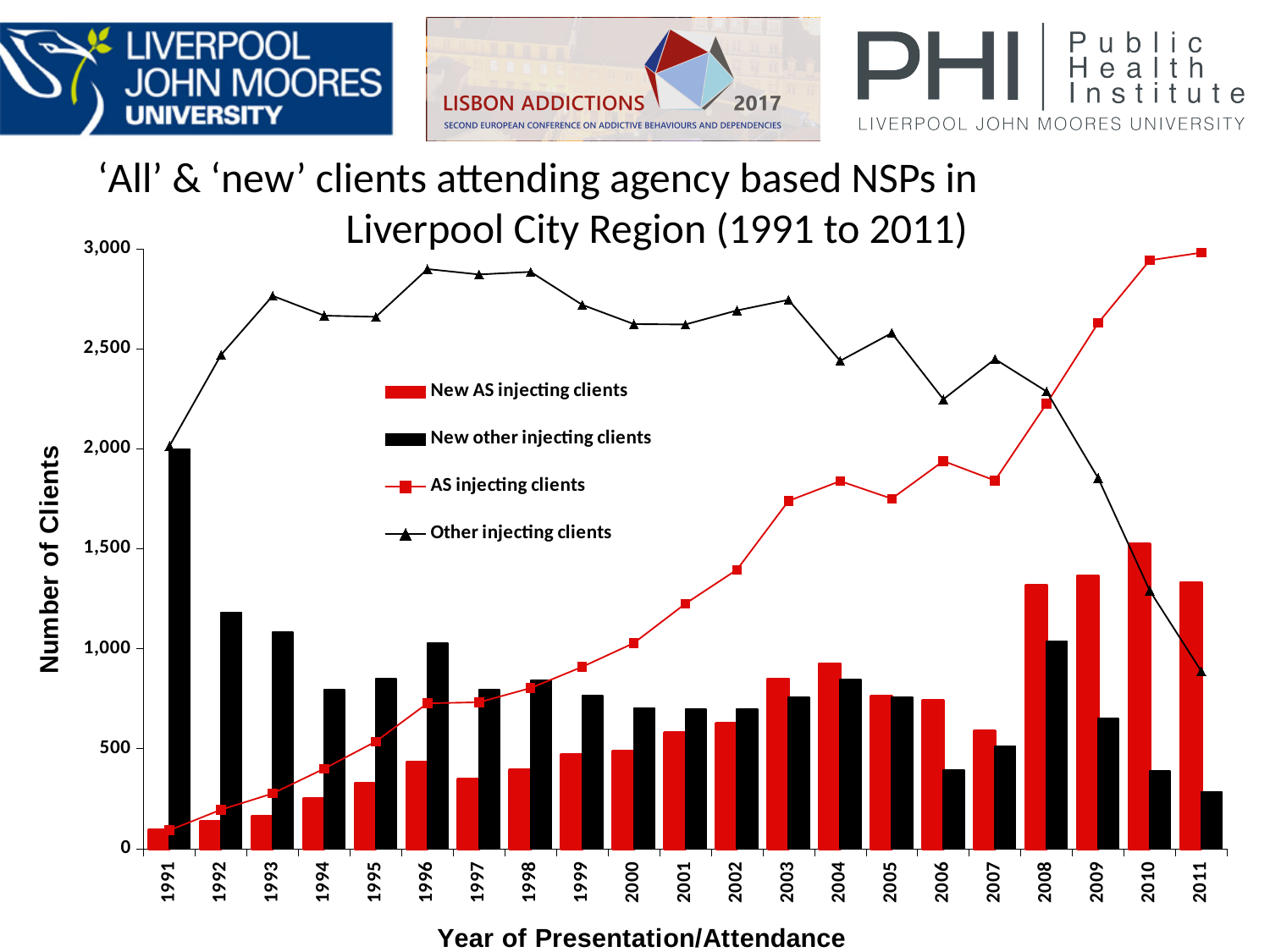
Is the value for Other injecting clients in 2011 greater or less than 1,000? less Which year has the lowest value for New AS injecting clients? 1991 Do the values for AS injecting clients generally rise or fall from 1991 to 2011? rise Which year has the highest value for New other injecting clients? 1991 How many series does the legend list? 4 Is the value for New other injecting clients in 1991 greater or less than 1,500? greater In 2011, which is larger: New AS injecting clients or New other injecting clients? New AS injecting clients Which year has the highest value for AS injecting clients? 2011 Which year has the lowest value for Other injecting clients? 2011 What kind of chart is this? Combined bar and line chart Is the value for AS injecting clients in 2011 greater or less than 2,500? greater How many years are shown on the x axis? 21